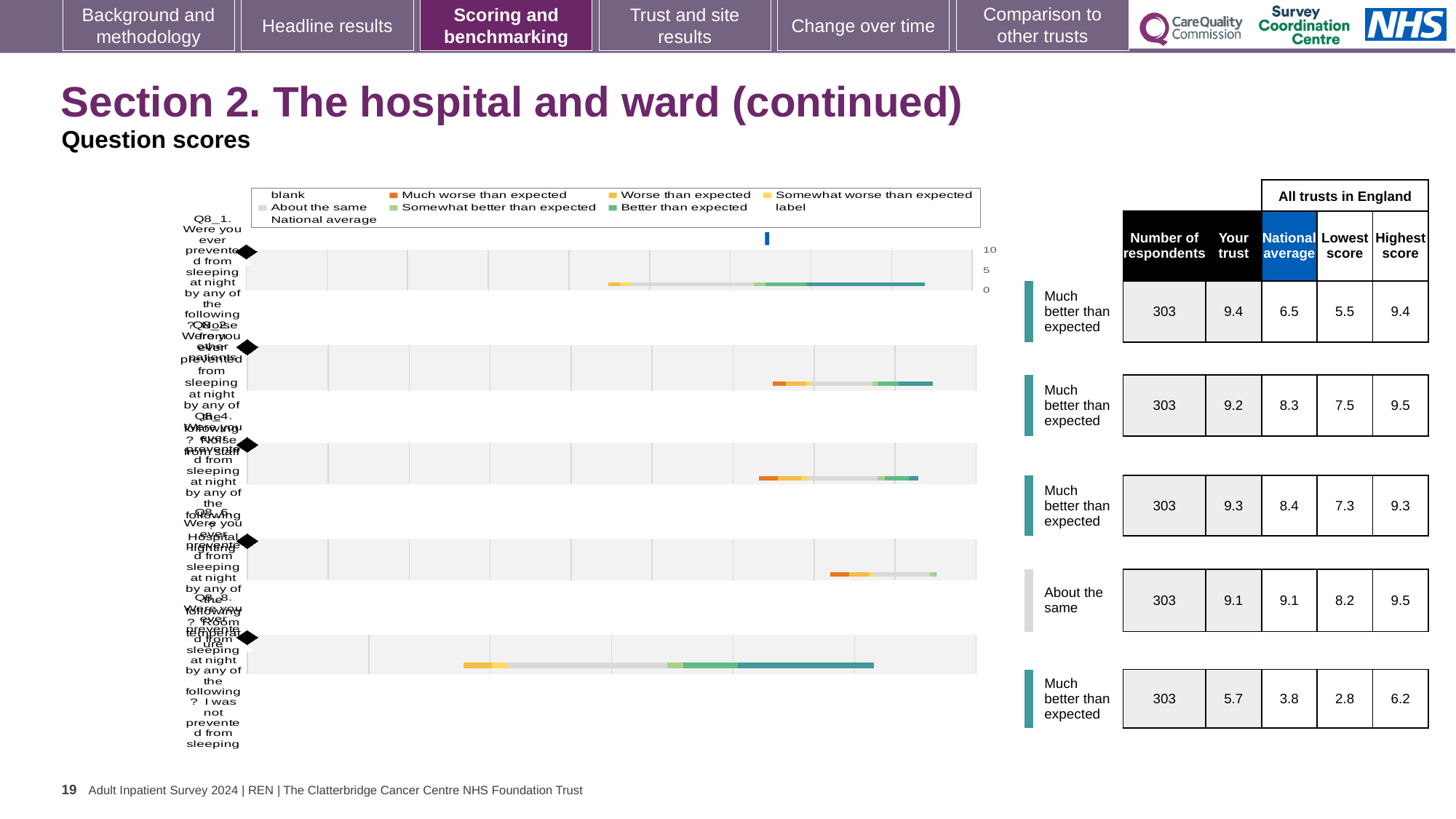
For the third row, which is larger: 'Your trust' (9.3) or 'National average' (8.4)? Your trust How many question rows (bars) are plotted in the chart? 5 What kind of chart is shown on the slide? bar chart What is the highest value shown on the chart's score axis? 10 In the table, what is the 'National average' for the bottom row? 3.8 Which row has the lowest 'Your trust' score in the table? the bottom row (5.7) What is the 'Lowest score' for the bottom row in the table? 2.8 Which row is rated 'About the same' rather than 'Much better than expected'? the fourth row What is the 'Highest score' for the second row in the table? 9.5 In the table, what is the number of respondents for the second row? 303 What is the difference between 'Your trust' and 'National average' for the top row? 2.9 In the table, what is the 'Your trust' score for the top row? 9.4